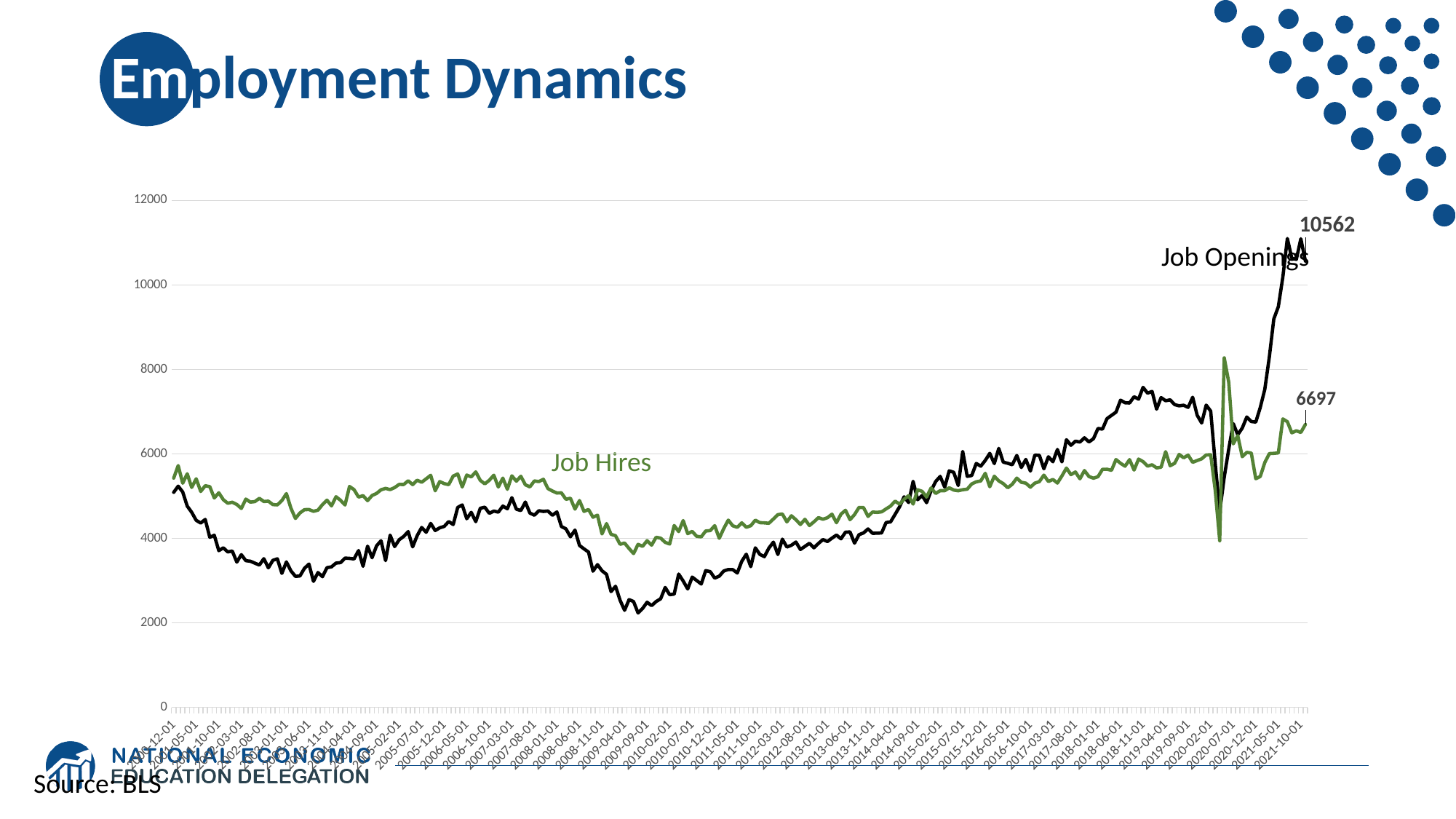
What kind of chart is shown on the slide? Line chart At the end of the series, which is higher: Job Openings or Job Hires? Job Openings What is the title of the slide? Employment Dynamics What is the final labelled value of the Job Hires series? 6697 Is the value of Job Openings around 2009-09-01 greater or less than 4000? less Does the Job Openings series rise or fall between 2009-09-01 and 2018-11-01? rise What is the final labelled value of the Job Openings series? 10562 Is the value of Job Hires at 2000-12-01 greater or less than 4000? greater What colour is the Job Hires line? Green Which series reaches the highest value anywhere on the chart? Job Openings How many data series are plotted on the chart? 2 What is the difference between the final labelled values of Job Openings (10562) and Job Hires (6697)? 3865